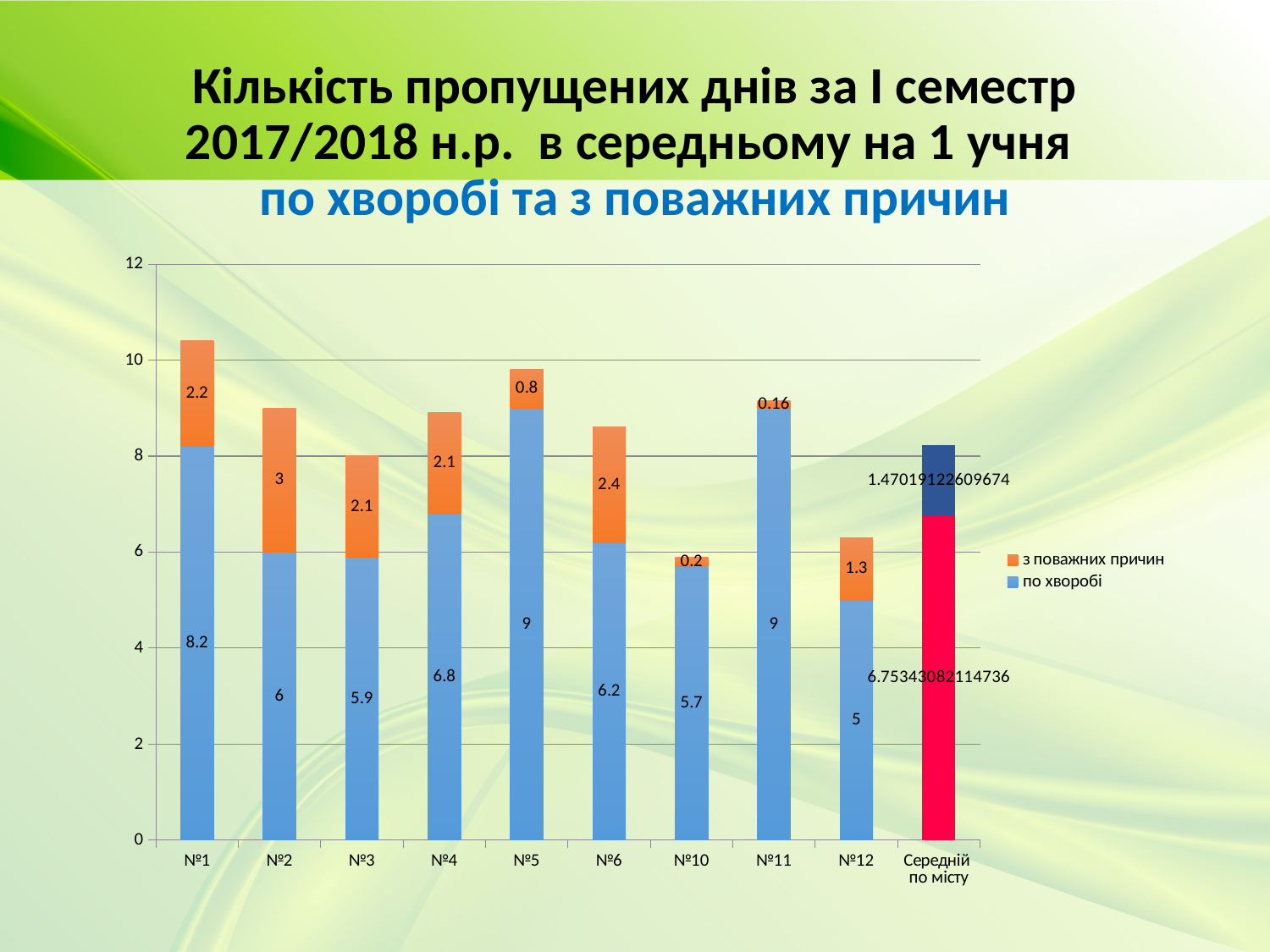
How many categories are shown on the x axis? 10 Which is larger, the 'з поважних причин' value for №6 or for №12? №6 What is the value of 'по хворобі' for №12? 5 What is the value of 'з поважних причин' for №2? 3 What is the value of 'з поважних причин' for №11? 0.16 Which category has the highest value for 'з поважних причин'? №2 What is the value of 'по хворобі' for №1? 8.2 What is the difference between the 'по хворобі' values for №5 and №10? 3.3 Which category has the lowest value for 'по хворобі'? №12 How many series does the legend list? 2 What type of chart is shown on the slide? bar chart What is the total of the stacked bar for №1? 10.4